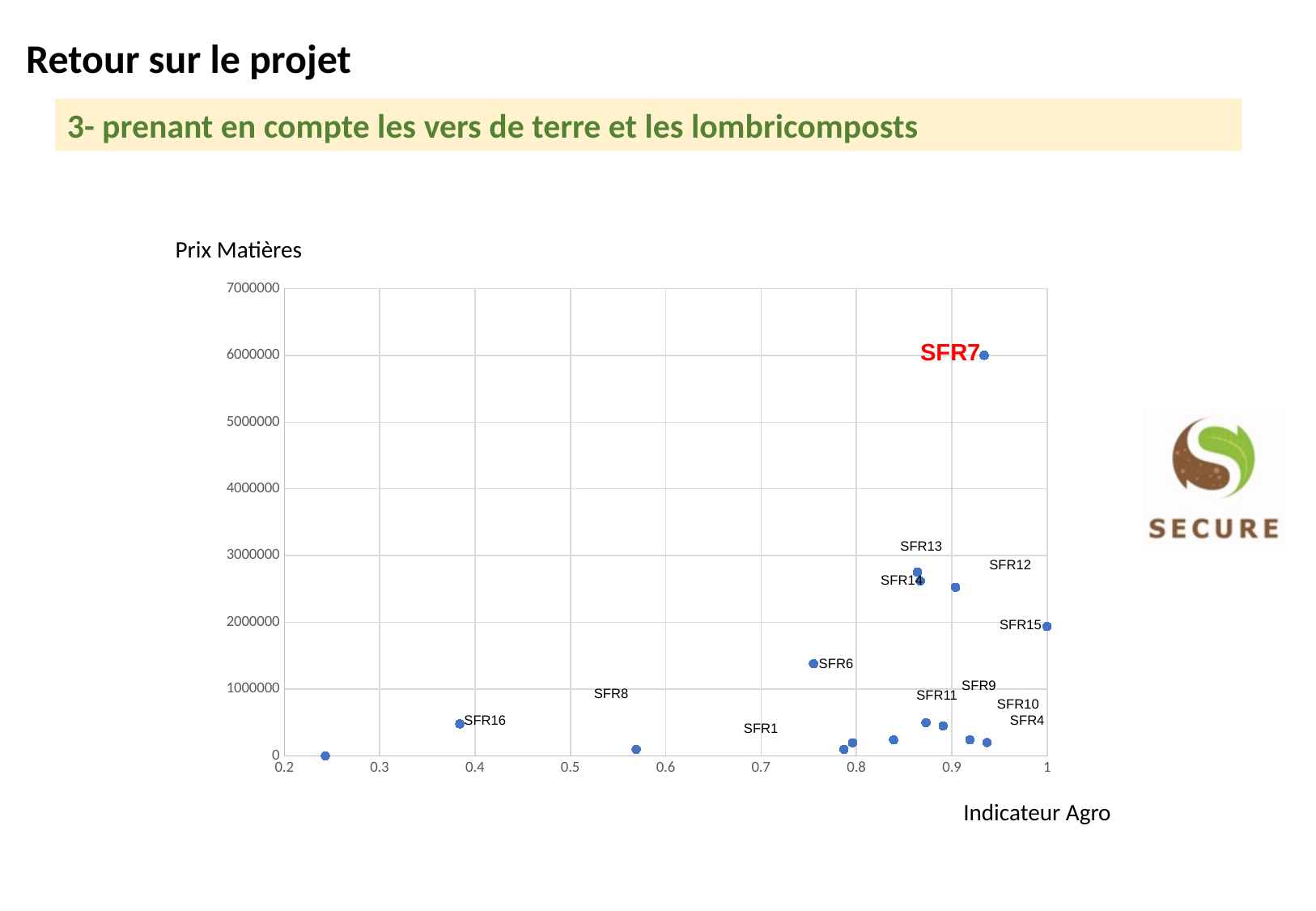
Which labelled point has the highest Prix Matières? SFR7 What kind of chart is shown on the slide? scatter chart What is the label of the horizontal axis? Indicateur Agro Is the Indicateur Agro value for SFR16 greater or less than 0.5? less Which has the higher Prix Matières, SFR16 or SFR8? SFR16 Is the Prix Matières value for SFR15 greater or less than 1000000? greater Which has the higher Prix Matières, SFR13 or SFR6? SFR13 Which point label is shown in red on the chart? SFR7 Is the Prix Matières value for SFR6 greater or less than 1000000? greater